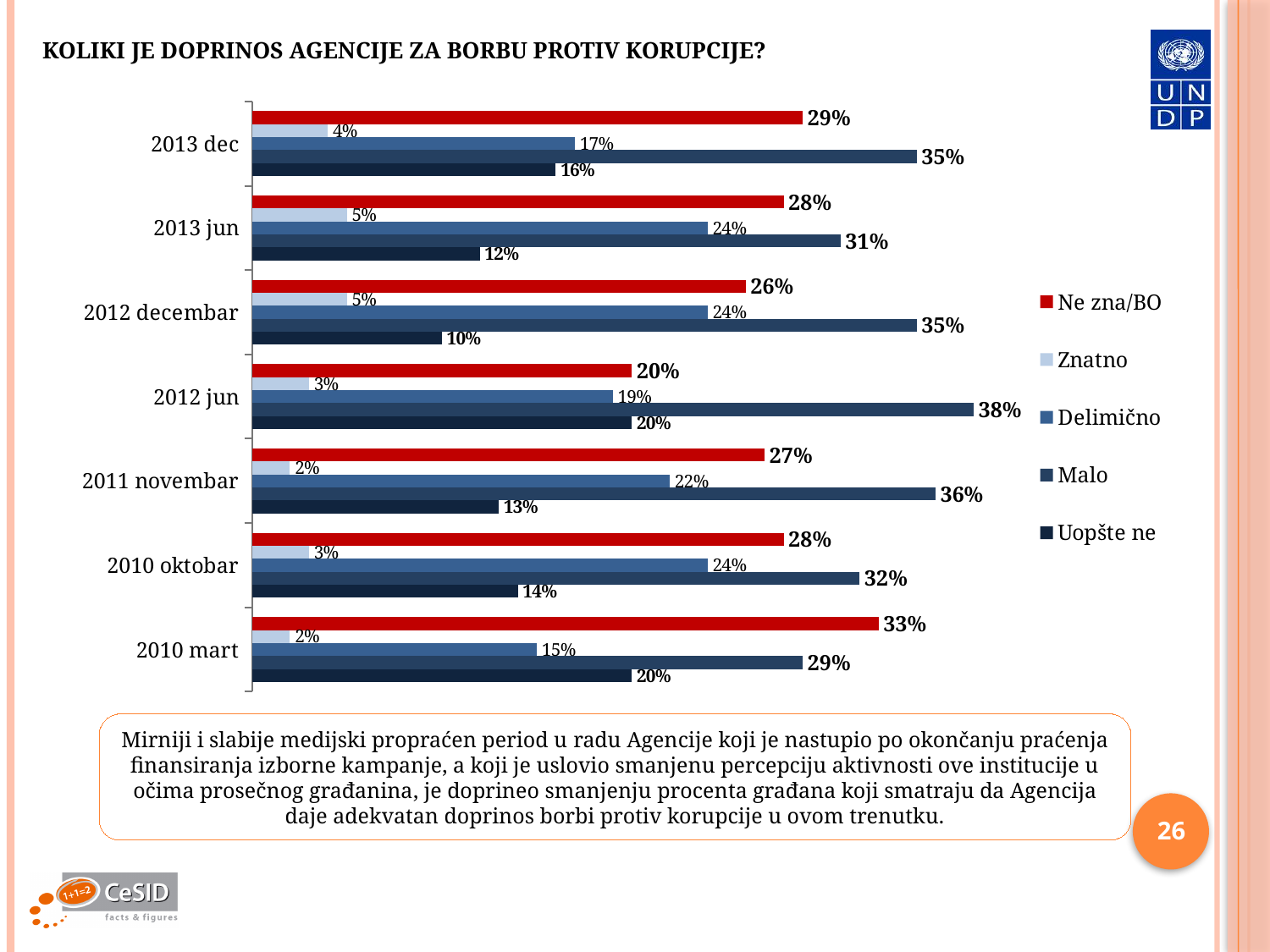
In which period is the value for Ne zna/BO the lowest? 2012 jun What is the value for Malo in 2013 dec? 35% Which is larger in 2013 jun: the value for Delimično or the value for Uopšte ne? Delimično What is the value for Ne zna/BO in 2010 mart? 33% What kind of chart is shown on the slide? bar chart Which series is shown in red on the chart? Ne zna/BO What is the difference between the Malo value and the Delimično value in 2011 novembar? 14% How many time periods (categories) are shown on the chart? 7 In which period is the value for Malo the highest? 2012 jun What is the value for Uopšte ne in 2012 decembar? 10% What is the value for Znatno in 2012 jun? 3% How many series does the legend list? 5